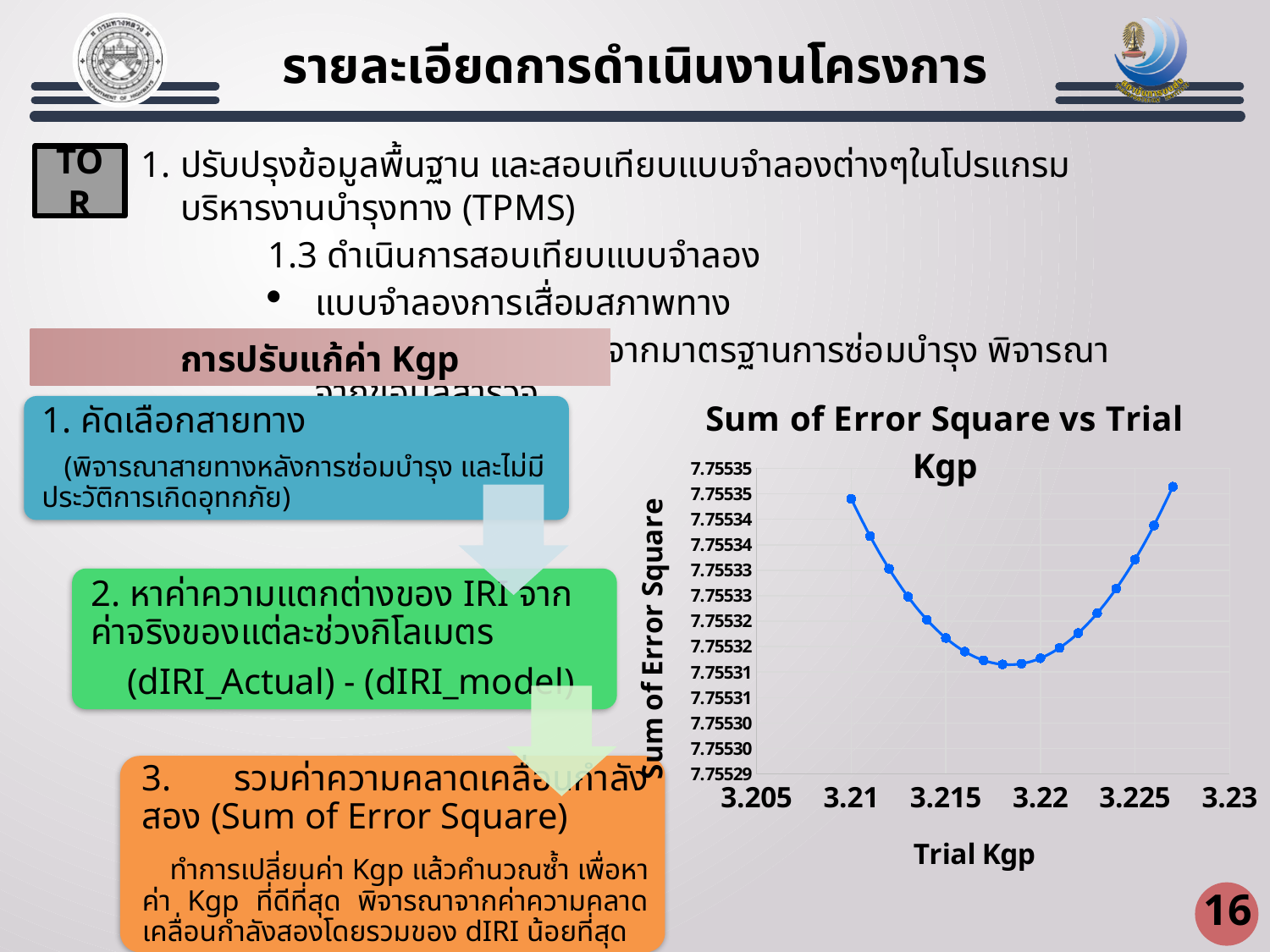
What kind of chart is shown on the slide? Line chart Is the Sum of Error Square at Trial Kgp 3.22 greater or less than 7.75533? less What is the label of the x axis of the chart? Trial Kgp Between which two x-axis ticks does the lowest Sum of Error Square occur? Between 3.215 and 3.22 At which end of the plotted range, the leftmost point (3.21) or the rightmost point (about 3.227), is the Sum of Error Square highest? Rightmost point Which has the larger Sum of Error Square, Trial Kgp 3.21 or Trial Kgp 3.22? 3.21 Is the Sum of Error Square at Trial Kgp 3.21 greater or less than 7.75532? greater Does the Sum of Error Square rise or fall as Trial Kgp increases from 3.21 to about 3.218? Fall Does the Sum of Error Square rise or fall as Trial Kgp increases from about 3.218 to 3.227? Rise What is the title of the chart? Sum of Error Square vs Trial Kgp Which has the larger Sum of Error Square, Trial Kgp 3.215 or Trial Kgp 3.225? 3.225